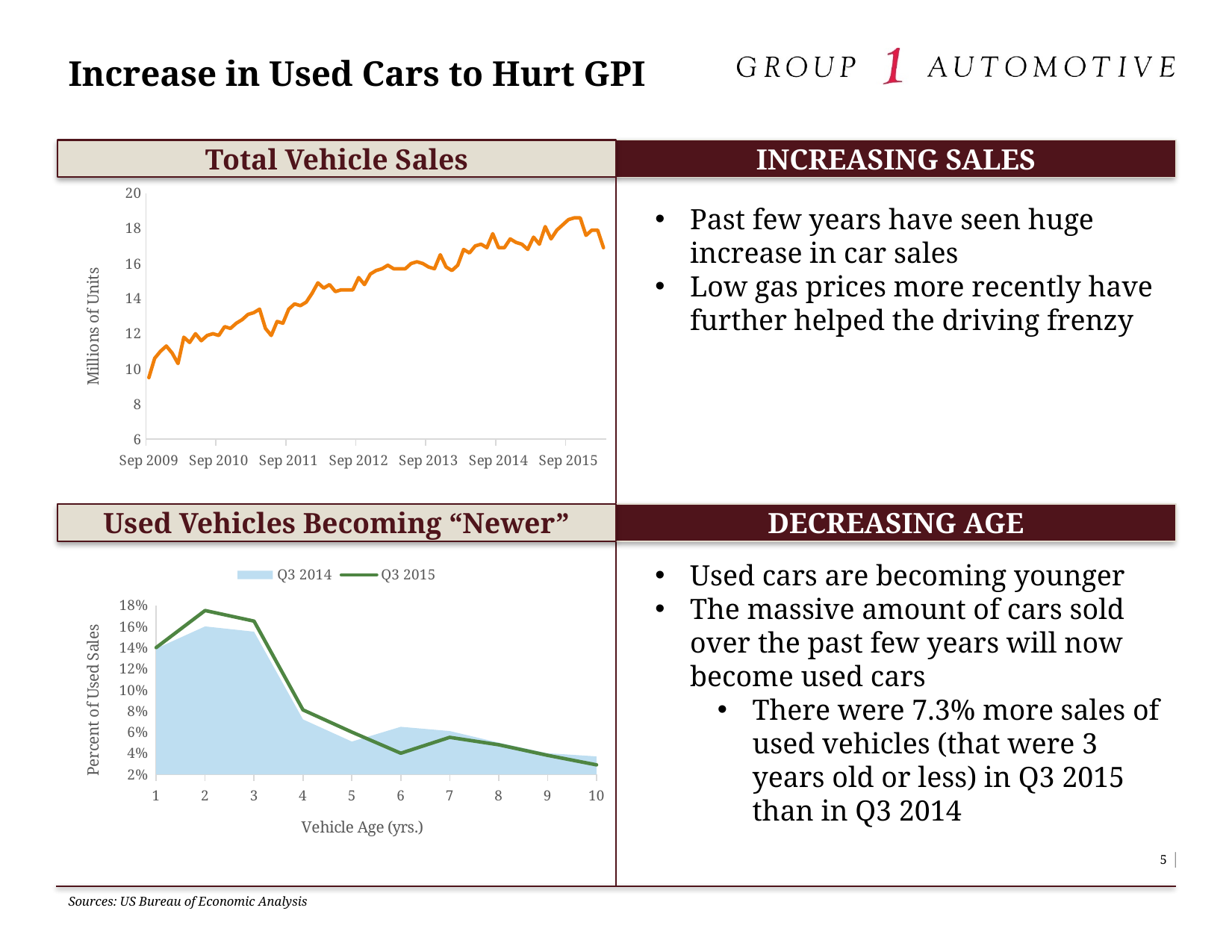
How many series does the legend of the "Used Vehicles Becoming "Newer"" chart list? 2 In the "Total Vehicle Sales" chart, is the value at Sep 2010 greater or less than 14 million units? less In the "Used Vehicles Becoming "Newer"" chart, at which vehicle age is the Q3 2015 share of used sales highest? 2 In the "Total Vehicle Sales" chart, what is the label on the vertical axis? Millions of Units What kind of chart is the "Total Vehicle Sales" chart? line chart In the "Used Vehicles Becoming "Newer"" chart, how many vehicle age categories are shown on the x axis? 10 In the "Total Vehicle Sales" chart, do vehicle sales generally rise or fall from Sep 2009 to Sep 2015? rise In the "Total Vehicle Sales" chart, is the value at Sep 2015 greater or less than 16 million units? greater In the "Used Vehicles Becoming "Newer"" chart, at vehicle age 2, which series is higher, Q3 2014 or Q3 2015? Q3 2015 In the "Used Vehicles Becoming "Newer"" chart, is the Q3 2015 value at vehicle age 2 greater or less than 16%? greater In the "Used Vehicles Becoming "Newer"" chart, at vehicle age 6, which series is higher, Q3 2014 or Q3 2015? Q3 2014